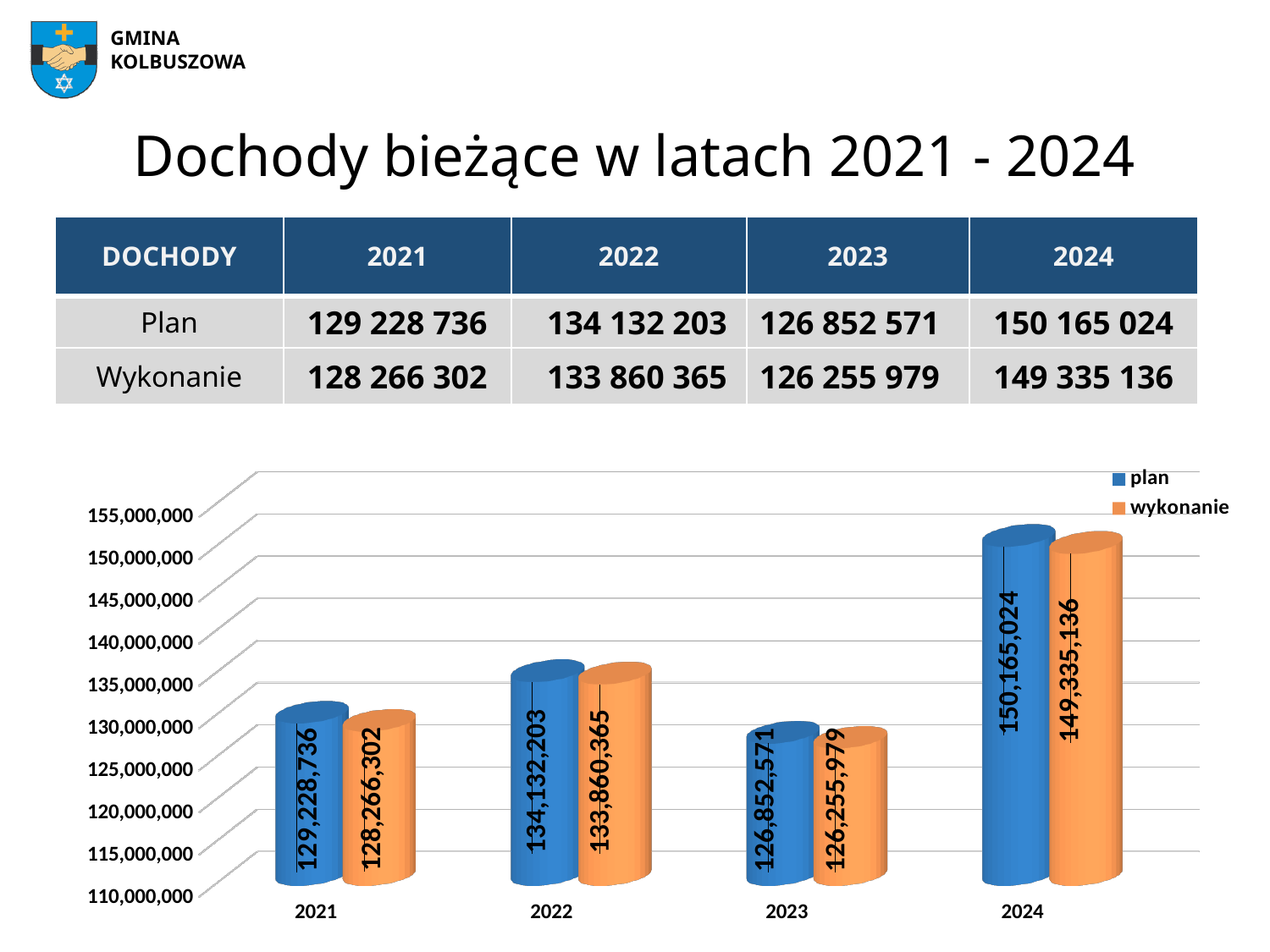
Which year has the lowest wykonanie value in the chart? 2023 What is the wykonanie value for 2022 in the chart? 133,860,365 What is the plan value for 2021 in the chart? 129,228,736 Which is larger in the chart for 2022: plan or wykonanie? plan What is the wykonanie value for 2023 in the chart? 126,255,979 What type of chart is shown on the slide? bar chart How many series does the chart legend list? 2 Which year has the highest plan value in the chart? 2024 What is the plan value for 2024 in the chart? 150,165,024 What is the difference between the plan and wykonanie values for 2024 in the chart? 829,888 How many years are shown on the x axis of the chart? 4 Is the wykonanie value for 2023 greater or less than 130,000,000? less